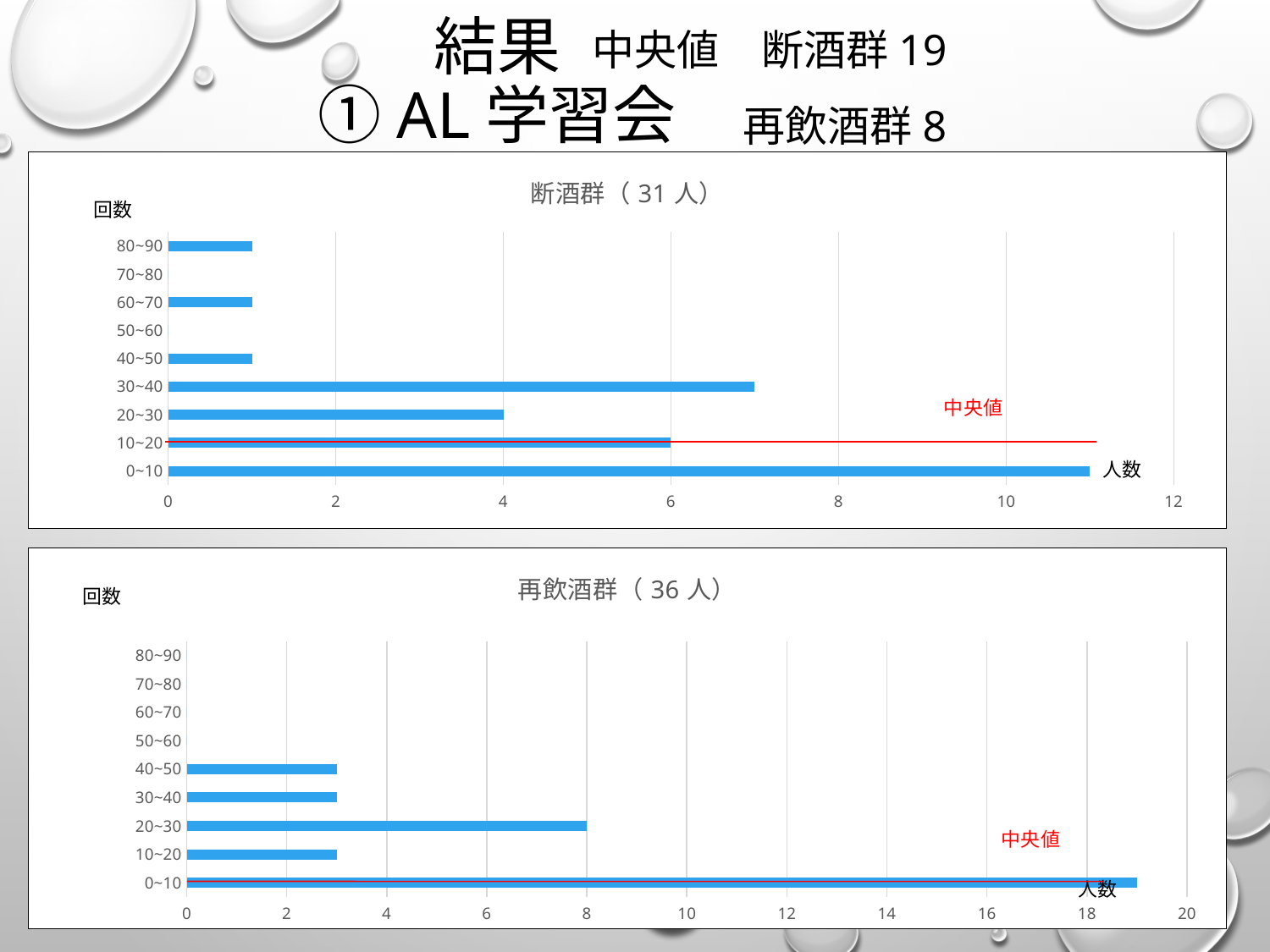
In the bottom chart (再飲酒群), is the value for 0~10 greater or less than 18? greater In the top chart (断酒群), is the value for 0~10 greater or less than 10? greater In the top chart (断酒群), what is the difference between the values for 10~20 and 20~30? 2 In the top chart (断酒群), what is the value for the 20~30 category? 4 In the top chart (断酒群), is the value for 30~40 greater or less than 6? greater In the bottom chart (再飲酒群), which is larger, the value for 20~30 or the value for 40~50? 20~30 In the top chart (断酒群), what is the value for the 10~20 category? 6 In the bottom chart (再飲酒群), what is the value for the 20~30 category? 8 In the top chart (断酒群), how many categories are shown on the vertical axis? 9 In the top chart (断酒群), which category has the highest value? 0~10 In the bottom chart (再飲酒群), which category has the highest value? 0~10 What kind of chart is the top chart titled 断酒群（31人）? bar chart